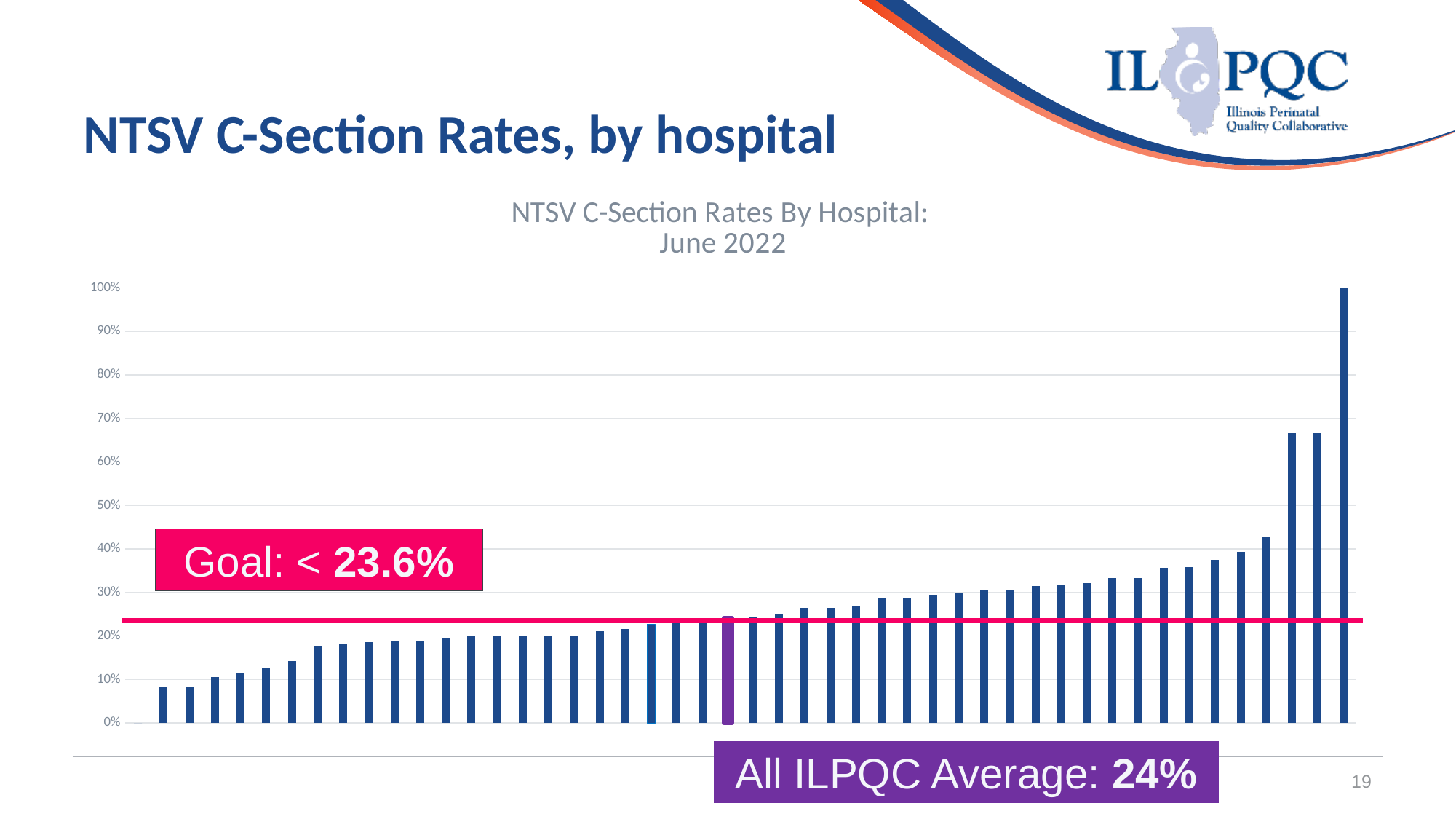
What is the title of the chart? NTSV C-Section Rates By Hospital: June 2022 What is the highest value shown on the y-axis? 100% Which is larger, the leftmost bar or the rightmost bar? The rightmost bar What value does the tallest bar on the chart reach? 100% What kind of chart is shown on the slide? Bar chart What goal value is shown in the pink box on the chart? < 23.6% What colour is the bar that marks the All ILPQC Average? Purple Is the value of the leftmost bar greater or less than 10%? less Is the value of the rightmost bar greater or less than 90%? greater Is the value of the second-tallest bar greater or less than 60%? greater What is the All ILPQC Average shown on the chart? 24% Do the bar values rise or fall from left to right across the chart? Rise